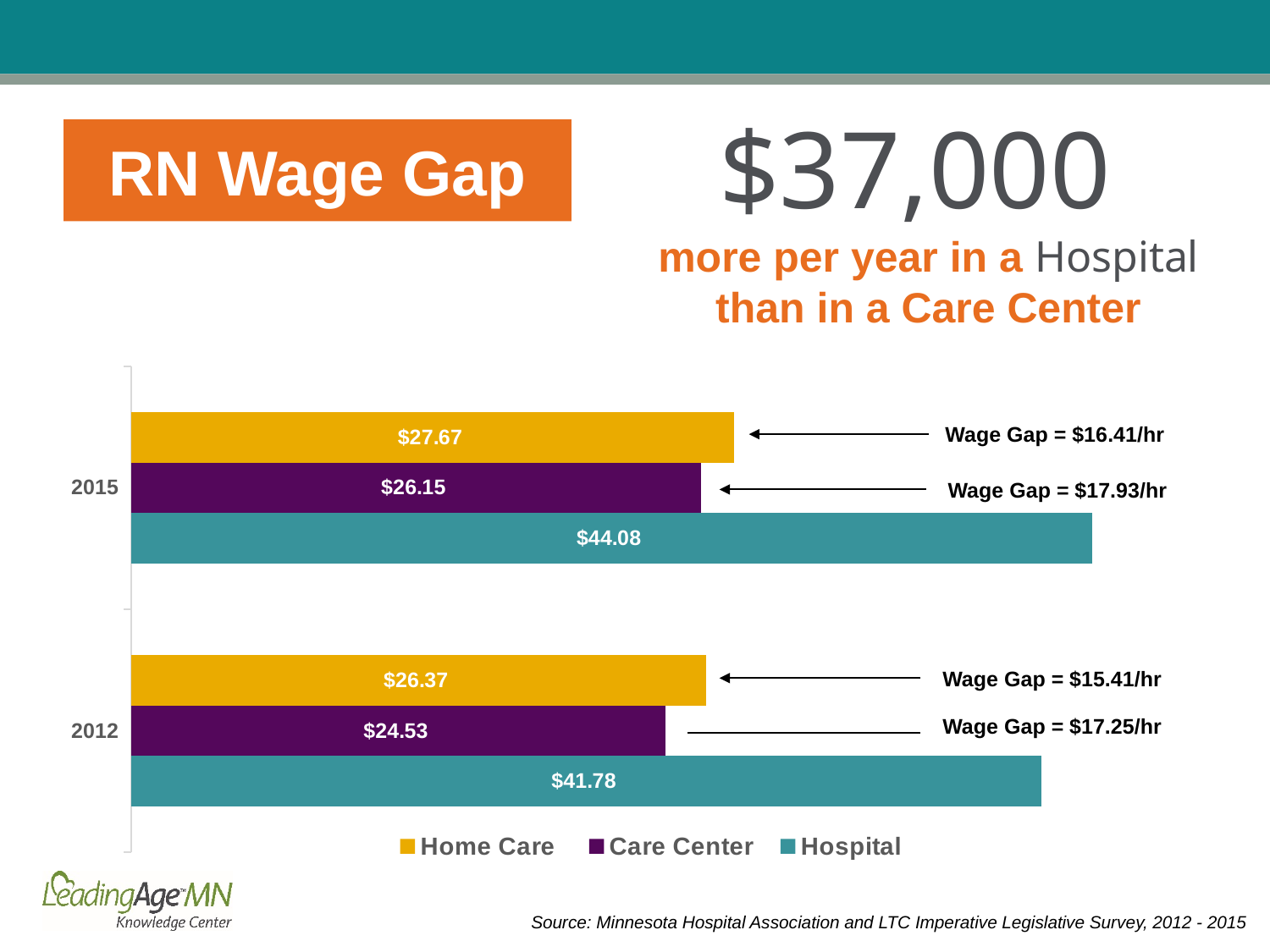
What kind of chart is shown on the slide? Bar chart Which setting has the highest RN wage in 2012? Hospital Which is larger, the Home Care wage in 2015 or the Home Care wage in 2012? Home Care wage in 2015 How many series does the legend list? 3 What is the Hospital RN wage for 2015? $44.08 What is the Home Care RN wage for 2015? $27.67 How many year categories are shown on the chart? 2 What is the Care Center RN wage for 2012? $24.53 What is the difference between the Hospital and Care Center wages in 2015? $17.93 Which colour represents Care Center in the chart? Purple What is the difference between the Hospital and Home Care wages in 2012? $15.41 Which setting has the lowest RN wage in 2015? Care Center